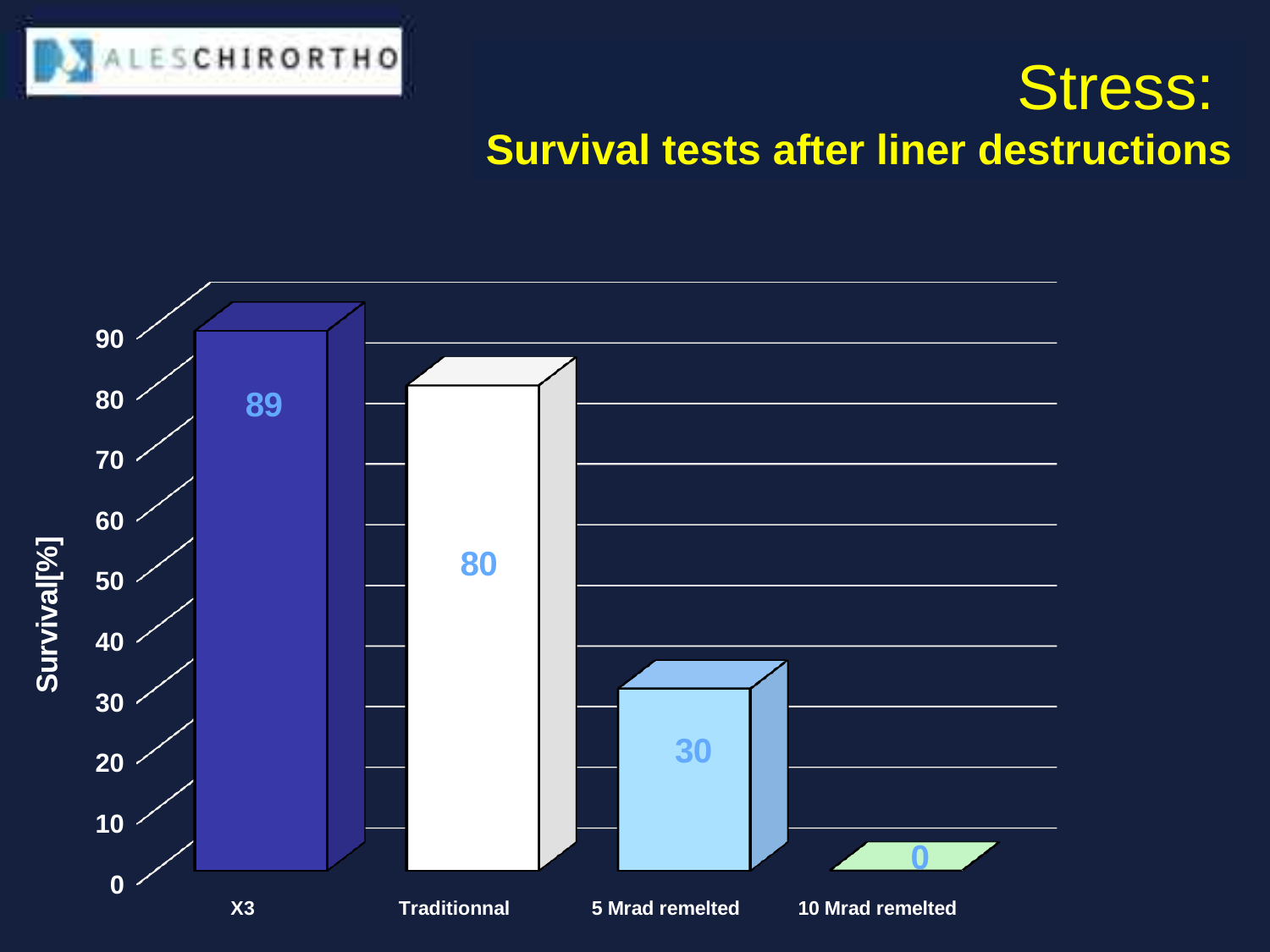
Which category has the lowest survival value? 10 Mrad remelted How many categories are shown on the x axis? 4 What is the survival value for X3? 89 What is the difference between the survival values for X3 and Traditionnal? 9 What is the survival value for 10 Mrad remelted? 0 What is the label of the vertical axis? Survival[%] What is the survival value for Traditionnal? 80 What kind of chart is shown on the slide? bar chart Which has a larger survival value, Traditionnal or 5 Mrad remelted? Traditionnal What is the difference between the survival values for Traditionnal and 5 Mrad remelted? 50 What is the survival value for 5 Mrad remelted? 30 Which category has the highest survival value? X3